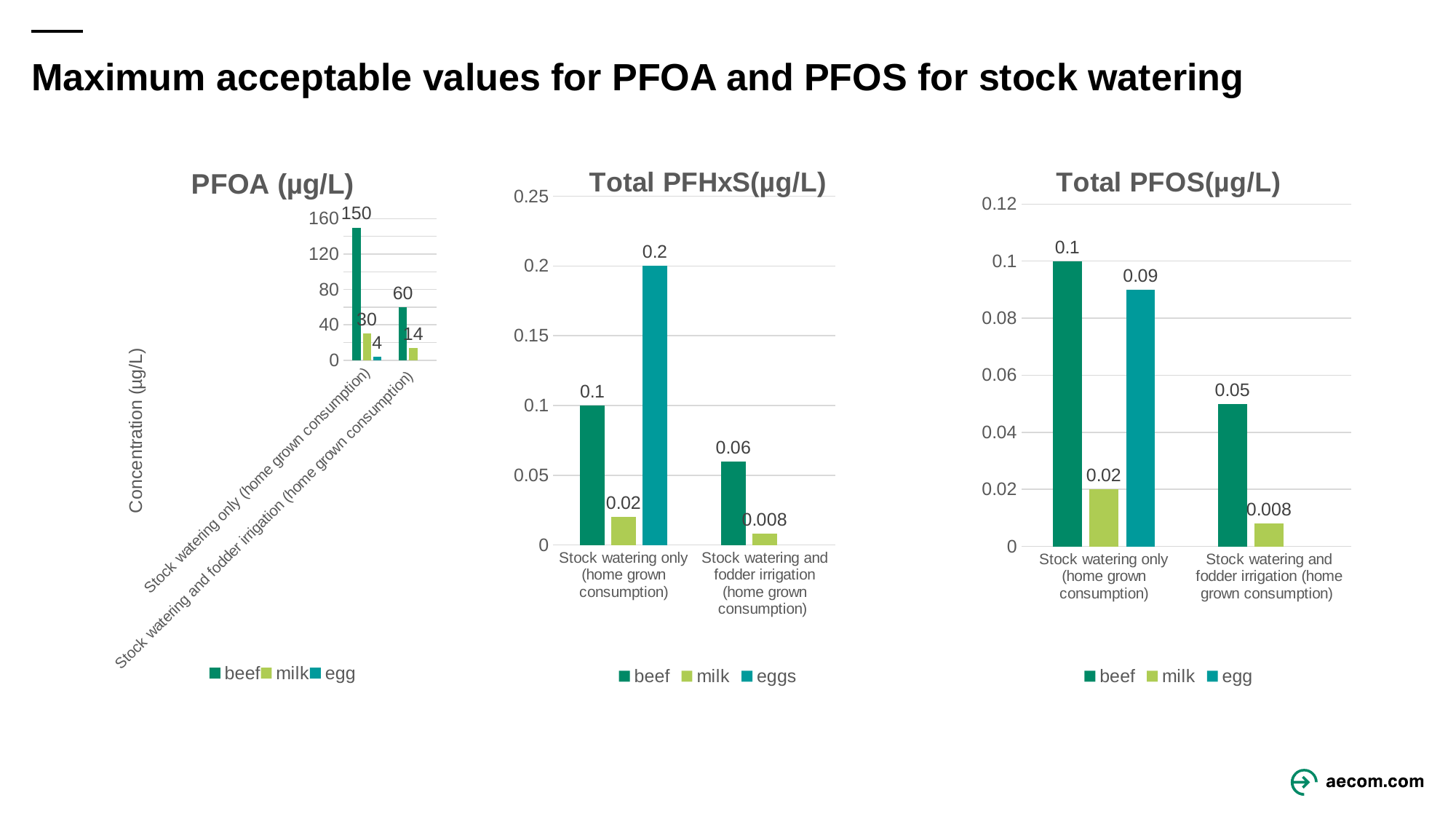
How many charts are shown on the slide? 3 What kind of chart is the Total PFHxS(µg/L) chart? bar chart In the Total PFOS(µg/L) chart, which series has the lowest value under Stock watering only (home grown consumption)? milk In the Total PFOS(µg/L) chart, what is the value for milk under Stock watering and fodder irrigation (home grown consumption)? 0.008 In the Total PFOS(µg/L) chart, what is the value for beef under Stock watering and fodder irrigation (home grown consumption)? 0.05 In the Total PFHxS(µg/L) chart, what is the difference between the beef value for Stock watering only and the beef value for Stock watering and fodder irrigation? 0.04 In the PFOA (µg/L) chart, what is the difference between the beef values for Stock watering only and Stock watering and fodder irrigation? 90 In the PFOA (µg/L) chart, what is the value for beef under Stock watering only (home grown consumption)? 150 How many series does the legend of the Total PFOS(µg/L) chart list? 3 In the Total PFHxS(µg/L) chart, what is the value for eggs under Stock watering only (home grown consumption)? 0.2 In the Total PFOS(µg/L) chart, which is larger under Stock watering only: beef or egg? beef In the Total PFHxS(µg/L) chart, which series has the highest value under Stock watering only (home grown consumption)? eggs